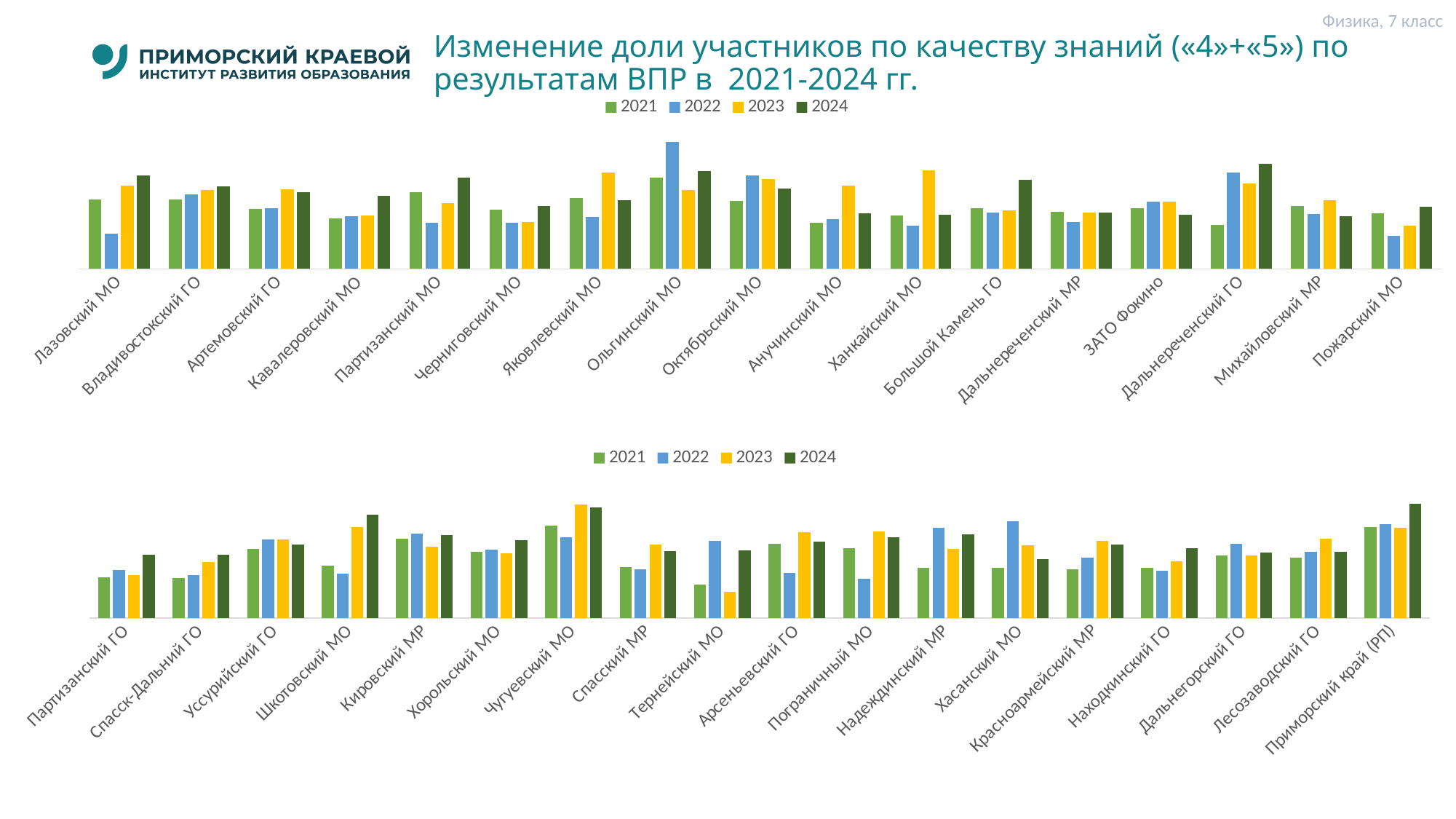
In the top chart, which category has the tallest bar overall? Ольгинский МО In the bottom chart, for Тернейский МО, which is larger: the 2022 value or the 2023 value? 2022 Which years are listed in the legend of the bottom chart? 2021, 2022, 2023, 2024 In the bottom chart, do the values for Спасск-Дальний ГО rise or fall from 2021 to 2024? Rise How many categories are shown on the x axis of the bottom chart? 18 In the bottom chart, for Хасанский МО, which is larger: the 2021 value or the 2022 value? 2022 In the top chart, for Ольгинский МО, which is larger: the 2021 value or the 2022 value? 2022 How many categories are shown on the x axis of the top chart? 17 How many series does the legend of the top chart list? 4 In the bottom chart, which category has the shortest bar overall? Тернейский МО What kind of chart is the top chart on the slide? Bar chart